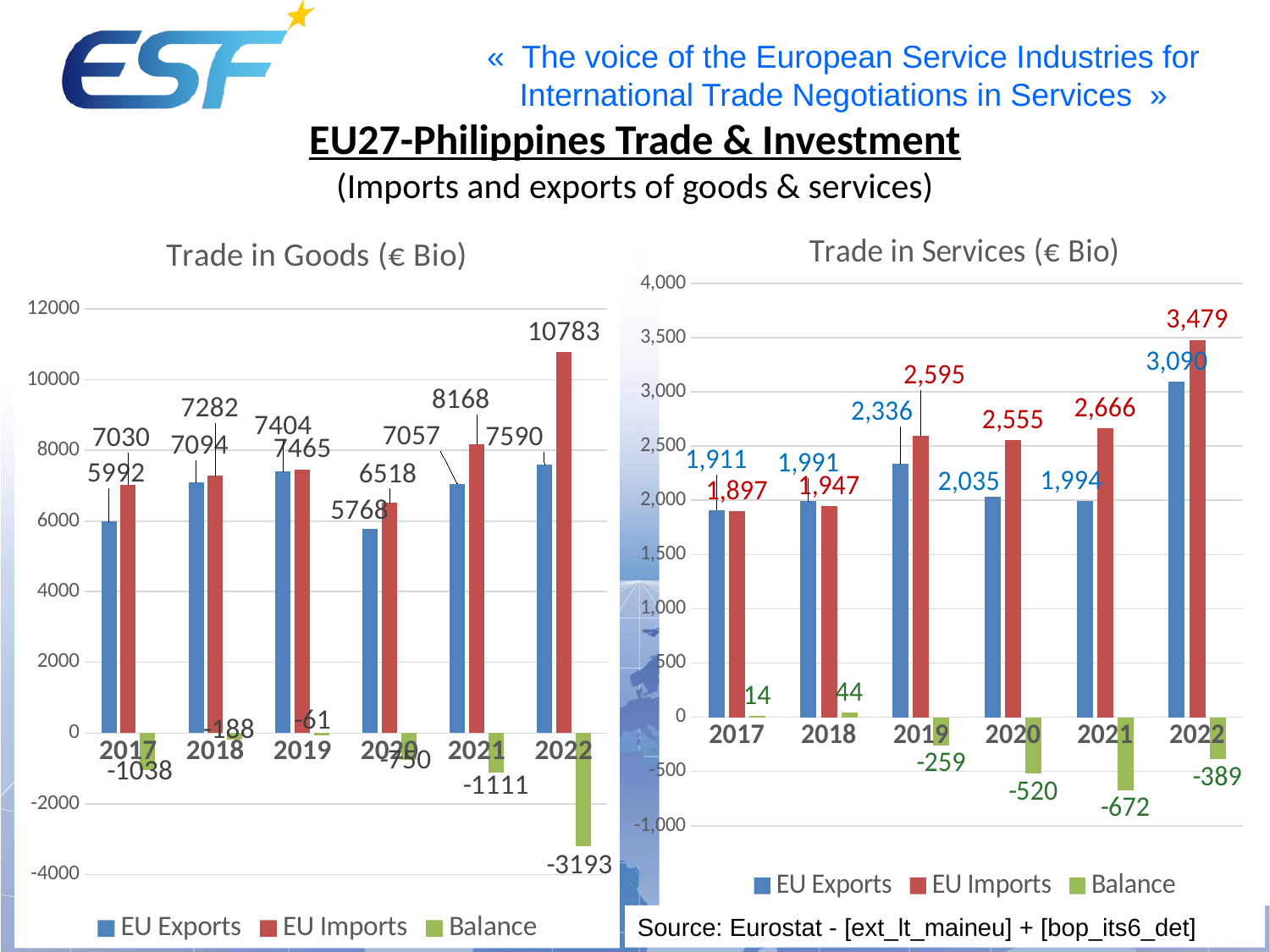
How many series does the legend of the Trade in Goods chart list? 3 In the Trade in Services chart, what is the difference between EU Imports and EU Exports in 2022? 389 In the Trade in Services chart, what is the Balance value for 2018? 44 In the Trade in Goods chart, what is the value of EU Exports in 2020? 5768 In the Trade in Services chart, what is the value of EU Imports in 2021? 2,666 In the Trade in Goods chart, what is the difference between EU Imports and EU Exports in 2017? 1038 In the Trade in Goods chart, what is the Balance value for 2021? -1111 In the Trade in Services chart, which year has the lowest Balance value? 2021 In the Trade in Goods chart, what is the value of EU Imports in 2022? 10783 In the Trade in Goods chart, which year has the highest EU Imports value? 2022 In the Trade in Services chart, which is larger in 2017, EU Exports or EU Imports? EU Exports What type of chart is the Trade in Services chart? Bar chart